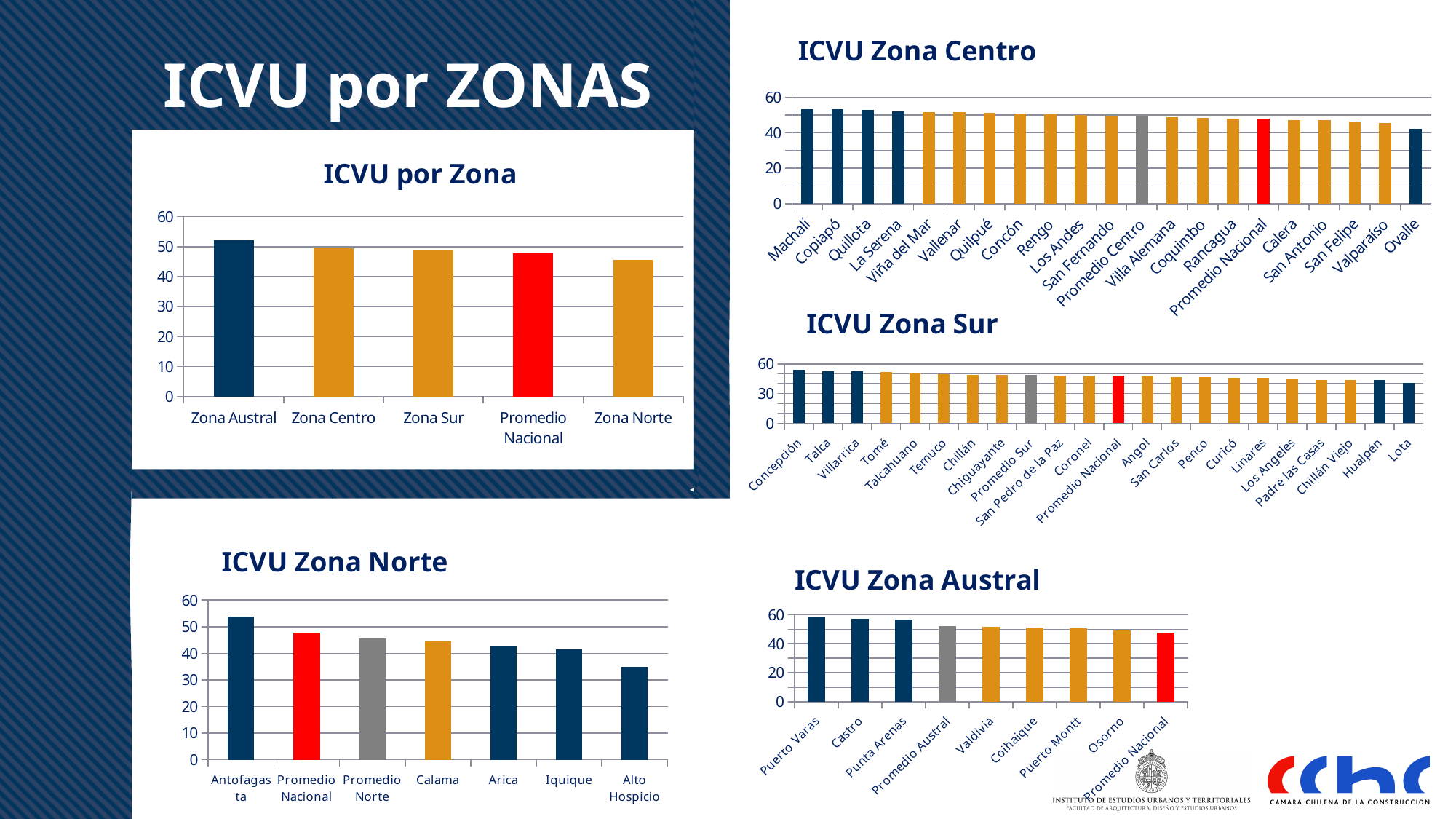
In the 'ICVU Zona Sur' chart, which category has the lowest value? Lota In the 'ICVU Zona Norte' chart, is the value for Alto Hospicio greater or less than 40? less In the 'ICVU Zona Austral' chart, which is larger, Puerto Varas or Osorno? Puerto Varas In the 'ICVU por Zona' chart, which zone has the highest value? Zona Austral In the 'ICVU Zona Norte' chart, how many categories are plotted? 7 In the 'ICVU por Zona' chart, is the value for Zona Austral greater or less than 50? greater In the 'ICVU por Zona' chart, how many categories are plotted? 5 In the 'ICVU por Zona' chart, which zone has the lowest value? Zona Norte What kind of chart is 'ICVU Zona Austral'? bar chart In the 'ICVU Zona Sur' chart, do the values rise or fall from left to right? fall In the 'ICVU Zona Norte' chart, which category has the highest value? Antofagasta In the 'ICVU Zona Centro' chart, which category has the lowest value? Ovalle